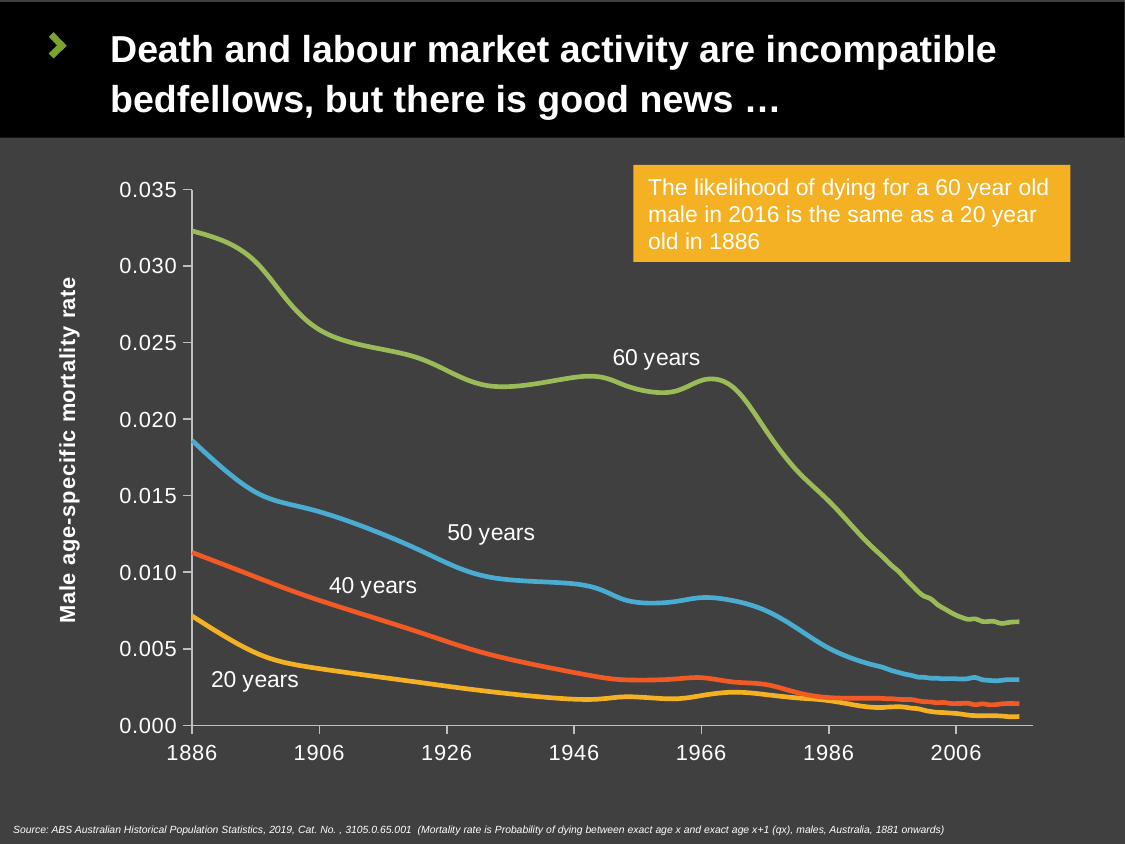
Is the mortality rate for 40 years in 1886 greater or less than 0.010? greater Is the mortality rate for 50 years in 1886 greater or less than 0.020? less Is the mortality rate for 60 years in 1966 greater or less than 0.020? greater Which age group has the lowest mortality rate across the whole period? 20 years What kind of chart is shown on the slide? line chart What is the title of the vertical axis? Male age-specific mortality rate Does the mortality rate for 60 year olds rise or fall from 1886 to the end of the series? fall In 1946, which is larger: the mortality rate for 50 years or for 40 years? 50 years How many age-group lines are plotted on the chart? 4 Which age group has the highest mortality rate across the whole period? 60 years